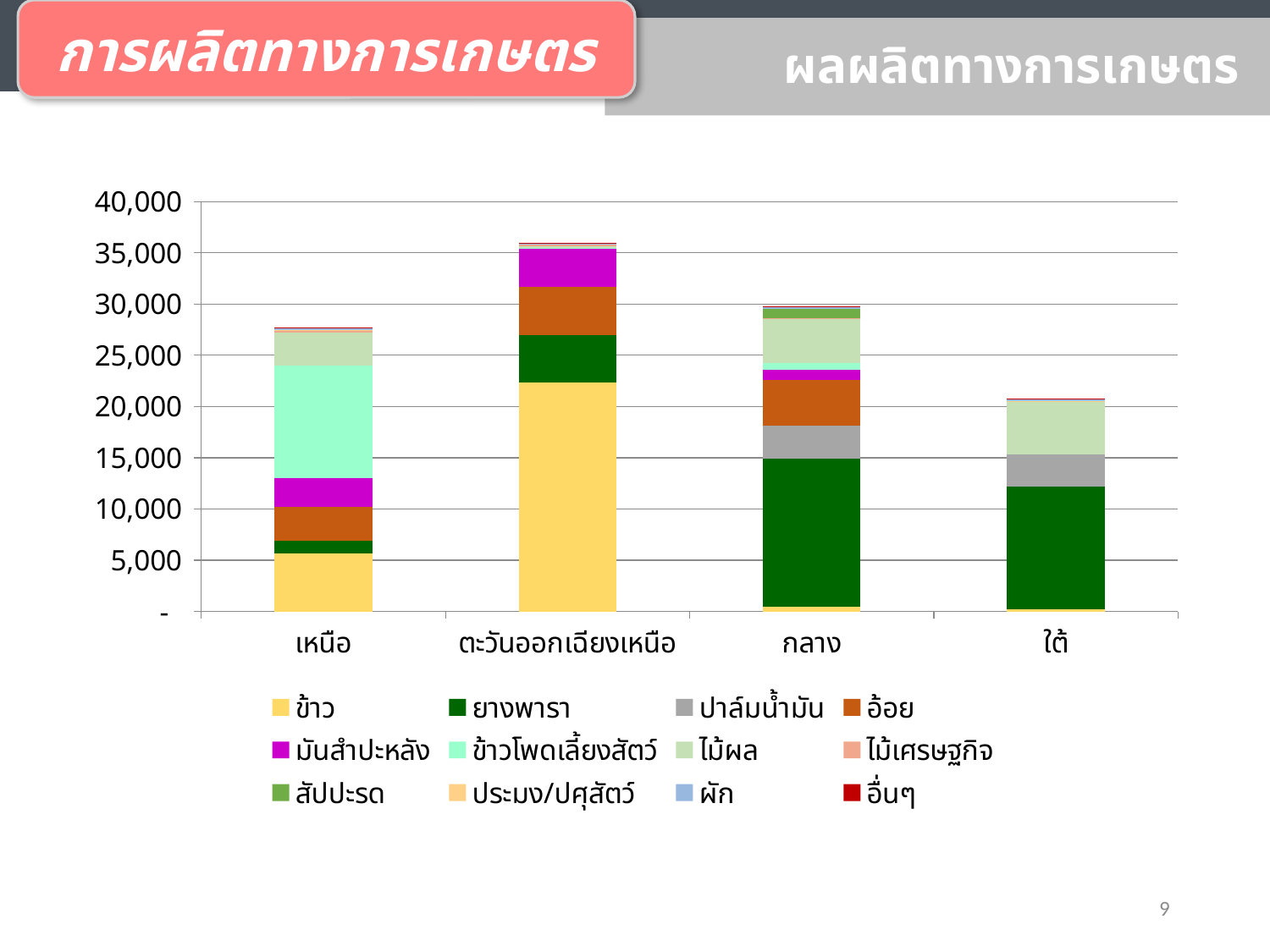
Is the total for ใต้ greater or less than 25,000? less Which region has the tallest stacked bar? ตะวันออกเฉียงเหนือ Which stacked bar is taller, เหนือ or ใต้? เหนือ Which series is shown in yellow in the legend? ข้าว What kind of chart is shown on the slide? stacked bar chart How many regions (categories) are shown on the x axis? 4 Is the total for กลาง greater or less than 25,000? greater How many series does the legend list? 12 Is the total for เหนือ greater or less than 25,000? greater Which region has the shortest stacked bar? ใต้ Which region has the largest ข้าว (yellow) segment? ตะวันออกเฉียงเหนือ